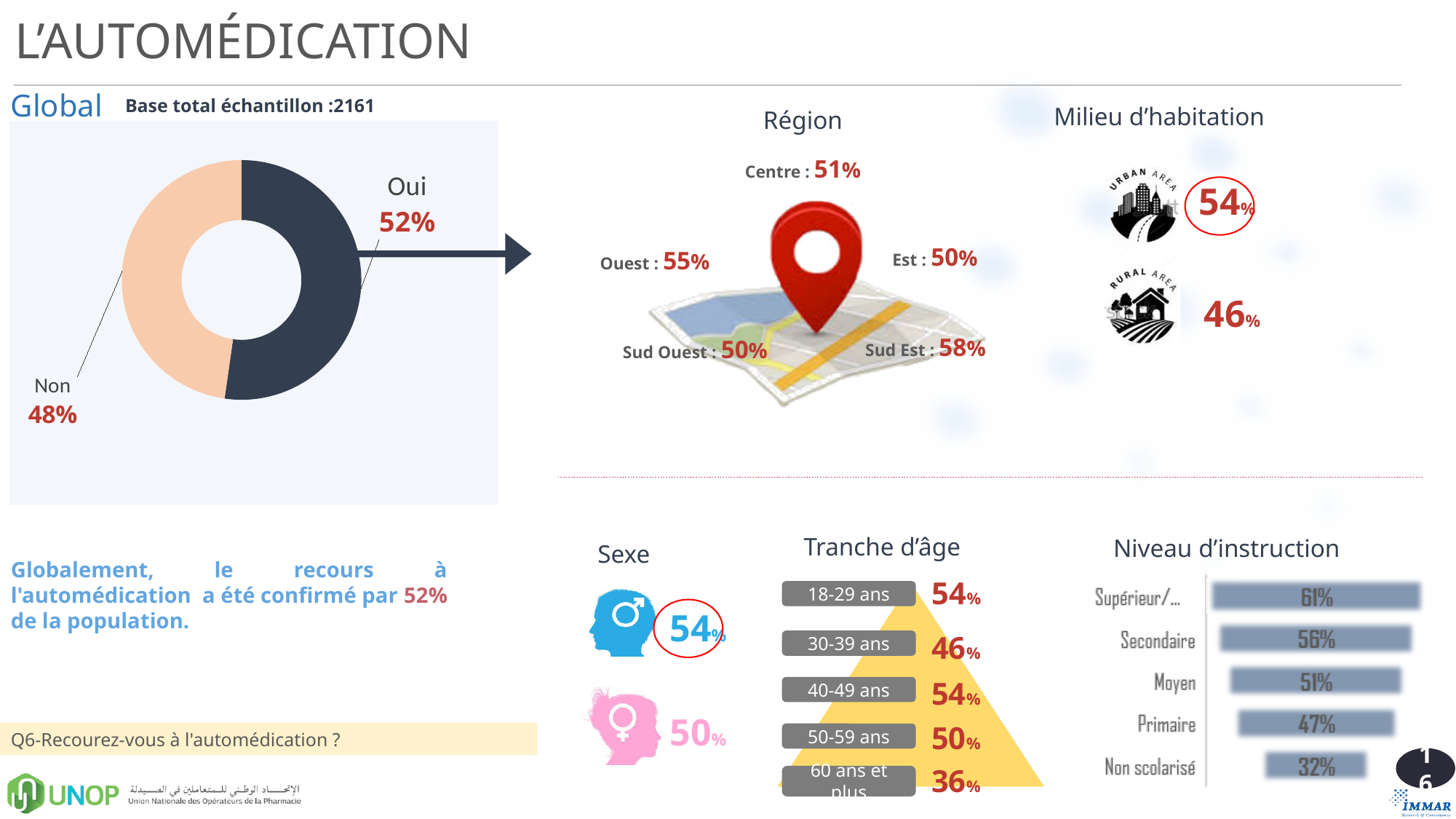
In the Global donut chart, which category has the larger share, Oui or Non? Oui In the Global donut chart, what percentage is shown for "Non"? 48% In the Niveau d'instruction bar chart, do the values rise or fall going from Supérieur down to Non scolarisé? Fall How many categories are shown in the Niveau d'instruction bar chart? 5 In the Niveau d'instruction bar chart, what is the value for Secondaire? 56% In the Global donut chart, what is the difference between the Oui and Non percentages? 4% In the Global donut chart, what percentage is shown for "Oui"? 52% What type of chart is used for the Global section on the left of the slide? Donut chart How many categories does the Global donut chart show? 2 In the Niveau d'instruction bar chart, which category has the lowest value? Non scolarisé In the Niveau d'instruction bar chart, what is the difference between Moyen and Primaire? 4% In the Niveau d'instruction bar chart, which category has the highest value? Supérieur/...